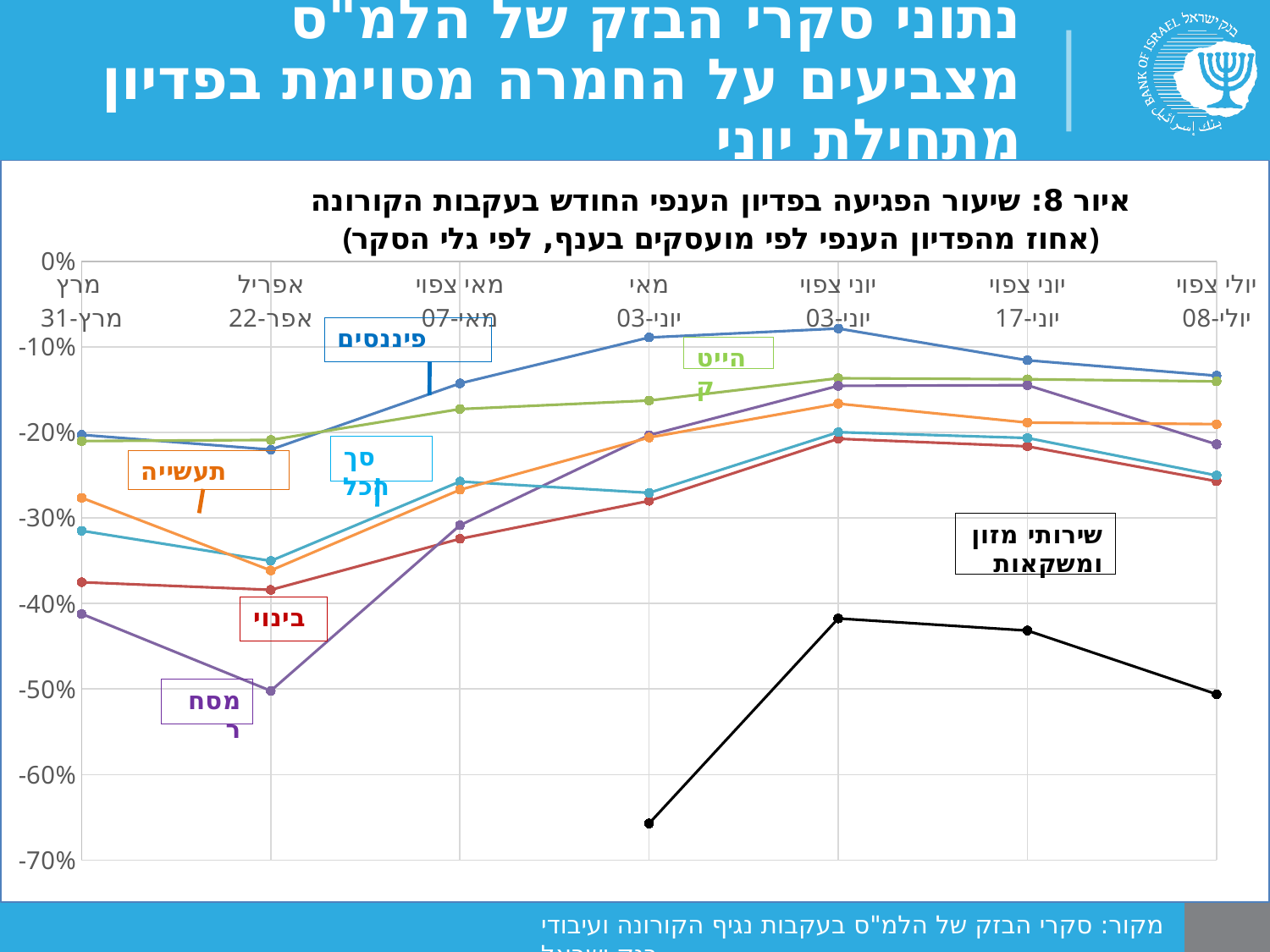
Is the value for שירותי מזון ומשקאות at the מאי (03-יוני) survey greater or less than -60%? less What is the figure number given in the chart title? איור 8 Is the value for תעשייה at the אפריל (22-אפר) survey greater or less than -30%? less Which sector has the lowest value at the last survey date (יולי צפוי, 08-יולי)? שירותי מזון ומשקאות Does the מסחר line rise or fall between the אפריל (22-אפר) survey and the יוני צפוי (03-יוני) survey? rise How many survey dates (points along the x axis) does the chart show? 7 Is the value for פיננסים at the יוני צפוי (03-יוני) survey greater or less than -10%? greater Which sector has the lowest value at the first survey date (מרץ, 31-מרץ)? מסחר How many sectors (series) are plotted on the chart? 7 At the אפריל (22-אפר) survey, which is higher: בינוי or מסחר? בינוי What kind of chart is shown on the slide? line chart